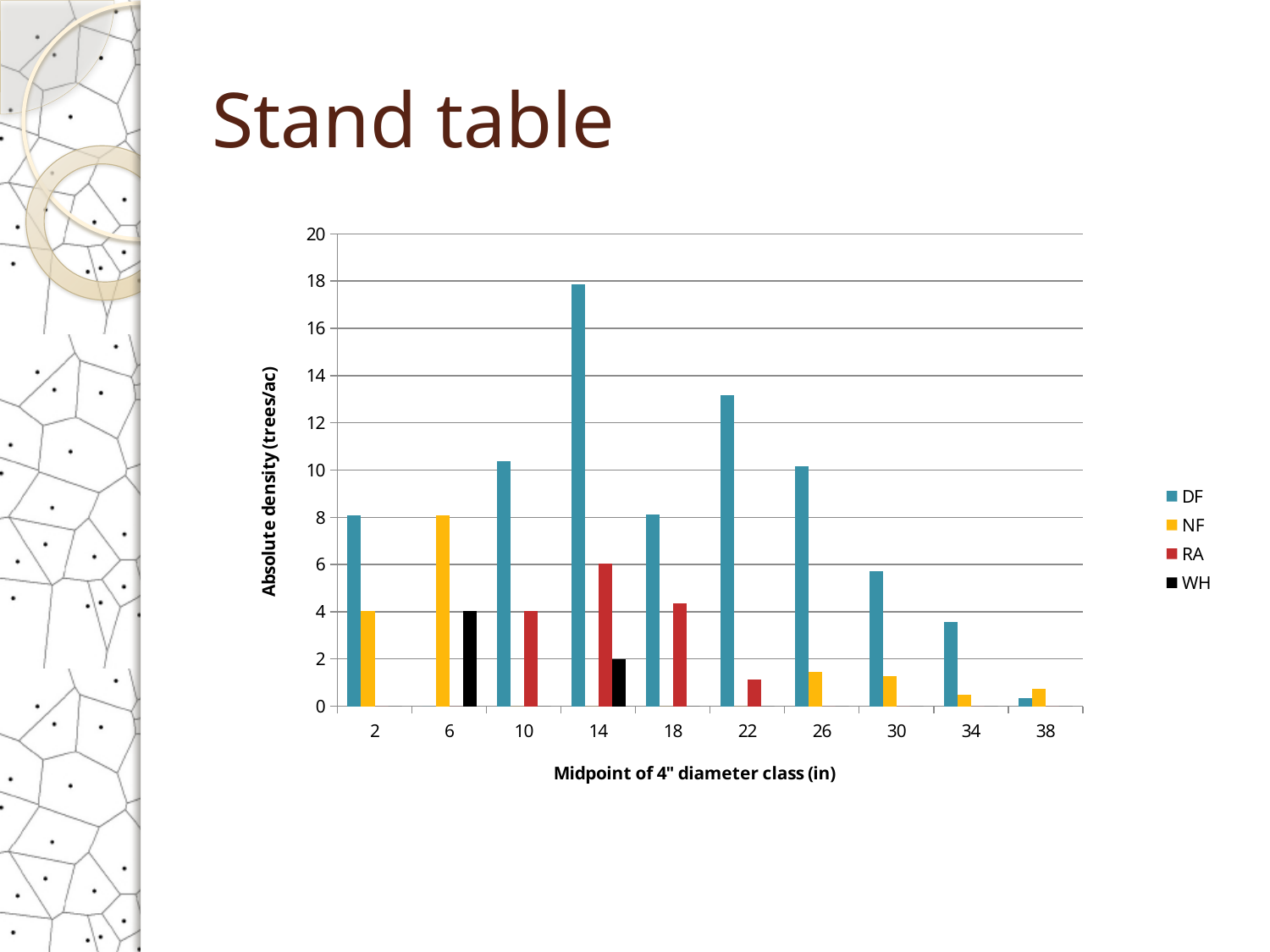
Is the DF value at the 14-inch midpoint greater or less than 16 trees/ac? greater At which diameter class midpoint is the DF density highest? 14 Is the DF value at the 30-inch midpoint greater or less than 6 trees/ac? less How many series does the legend list? 4 How many diameter class midpoints are shown on the x axis? 10 What is the label of the y axis? Absolute density (trees/ac) At which diameter class midpoint is the RA density highest? 14 Which has the larger DF density, the 22-inch midpoint or the 26-inch midpoint? 22 Is the DF value at the 22-inch midpoint greater or less than 12 trees/ac? greater What kind of chart is shown on the slide? bar chart